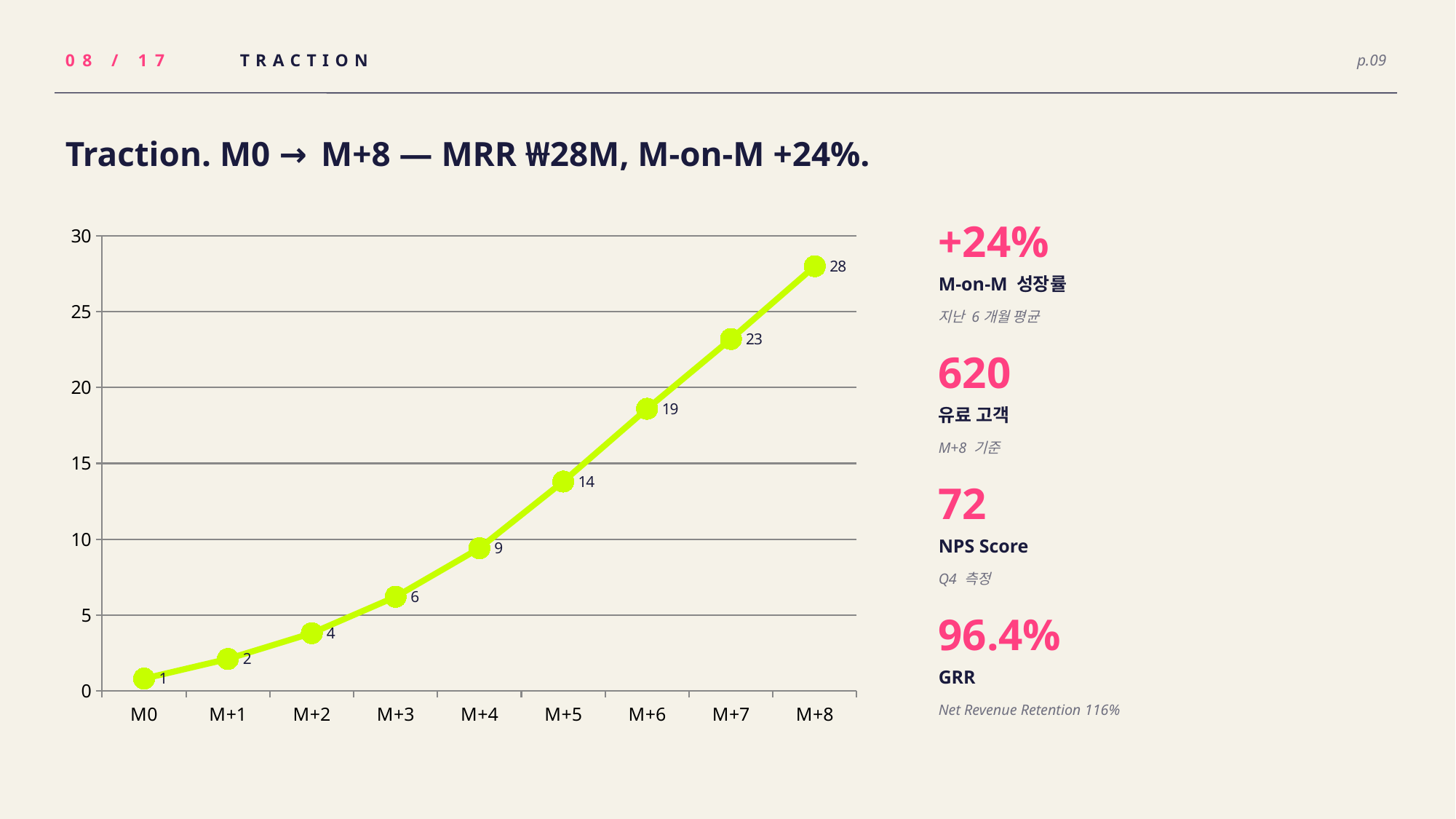
What is the difference between the values for M+5 and M+3? 8 What kind of chart is shown on the slide? line chart How many data points are plotted on the chart? 9 Which month has the lowest value on the chart? M0 What is the difference between the values for M+8 and M+7? 5 What is the value plotted for M+4? 9 Is the value for M+7 greater or less than 20? greater Do the values rise or fall from M0 to M+8? rise What is the value plotted for M+8? 28 What is the value plotted for M+6? 19 Which month has the highest value on the chart? M+8 Which is larger, the value for M+2 or the value for M+5? M+5